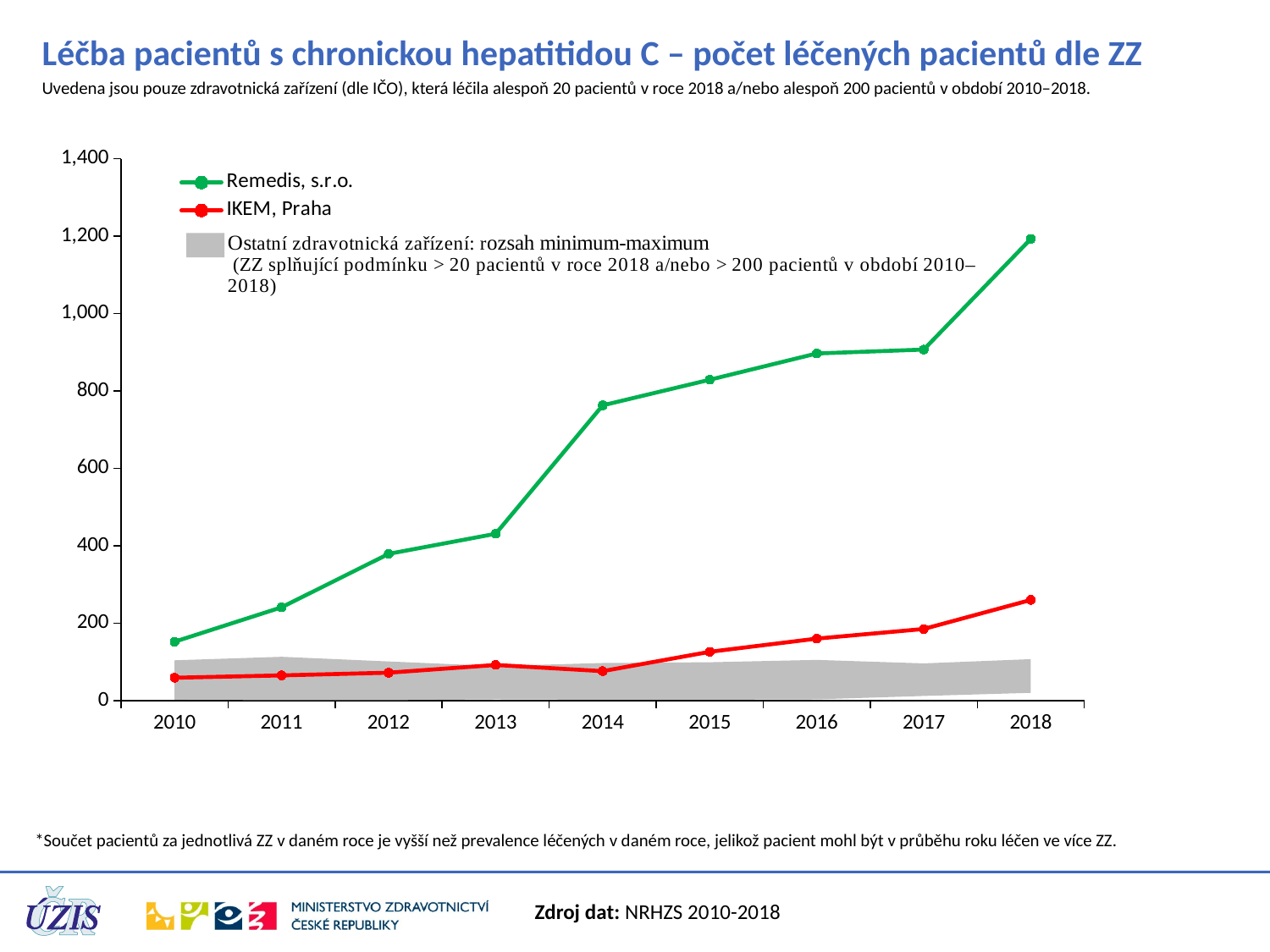
Is the value for IKEM, Praha in 2018 greater or less than 200? greater How many entries does the legend list? 3 What kind of chart is shown on the slide? line chart Is the value for Remedis, s.r.o. in 2018 greater or less than 1,000? greater Which has the larger value in 2018, Remedis, s.r.o. or IKEM, Praha? Remedis, s.r.o. In which year is the Remedis, s.r.o. value lowest? 2010 How many years are plotted along the x axis? 9 In which year does the Remedis, s.r.o. line reach its highest value? 2018 Is the value for Remedis, s.r.o. in 2010 greater or less than 200? less Does the Remedis, s.r.o. line generally rise or fall from 2010 to 2018? rise In which year does the IKEM, Praha line reach its highest value? 2018